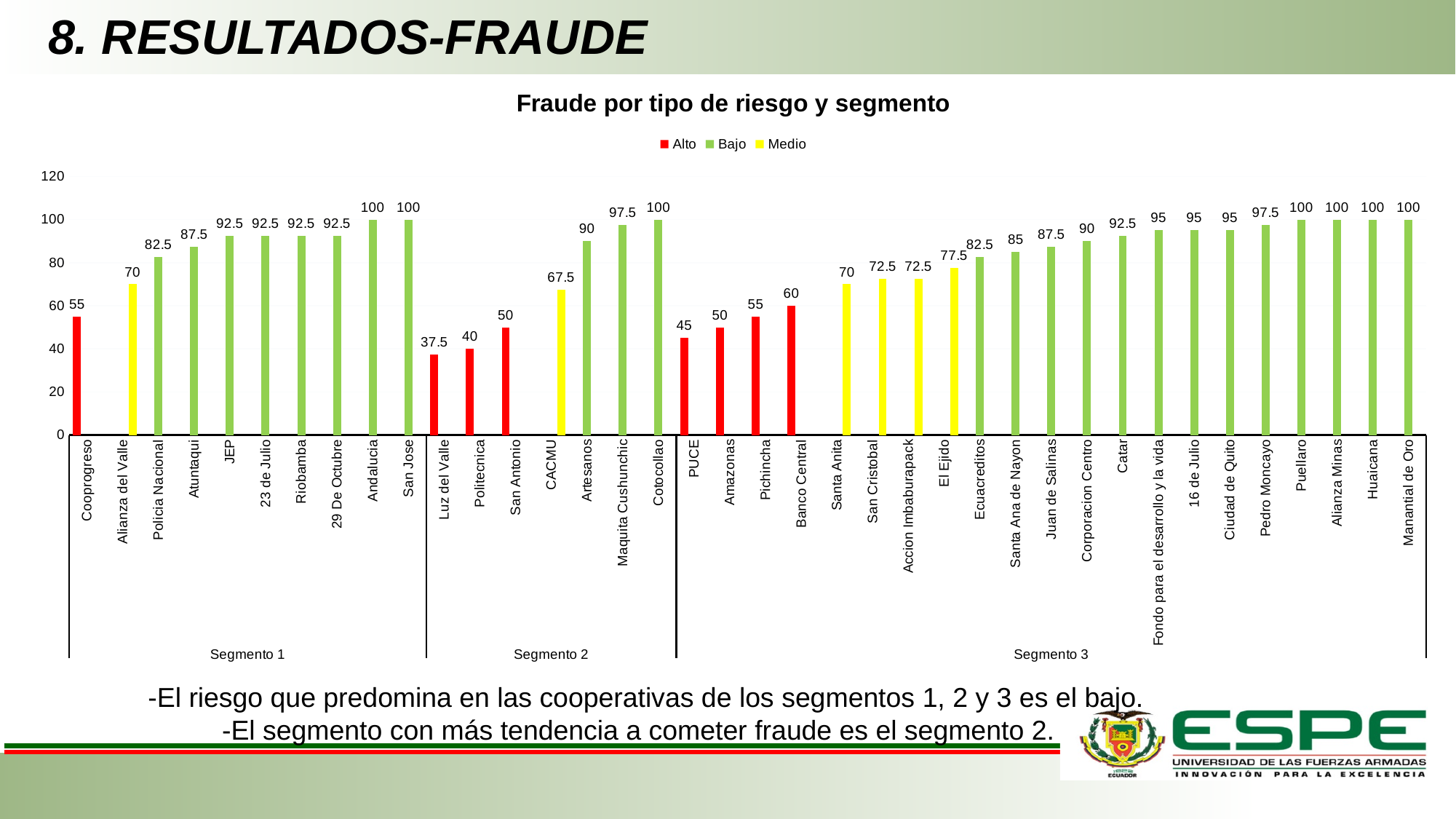
Which has a larger value, Politecnica or Pichincha? Pichincha What colour represents the 'Alto' series in the legend? Red What is the difference between the values for Cotocollao and Luz del Valle? 62.5 What is the value shown for El Ejido? 77.5 Which cooperative has the lowest value in the chart? Luz del Valle How many series does the legend list? 3 What is the value shown for Cooprogreso? 55 What is the value shown for CACMU? 67.5 What is the difference between the values for Banco Central and PUCE? 15 How many cooperatives are shown in Segmento 2? 7 What kind of chart is shown on the slide? Bar chart What is the value shown for Maquita Cushunchic? 97.5